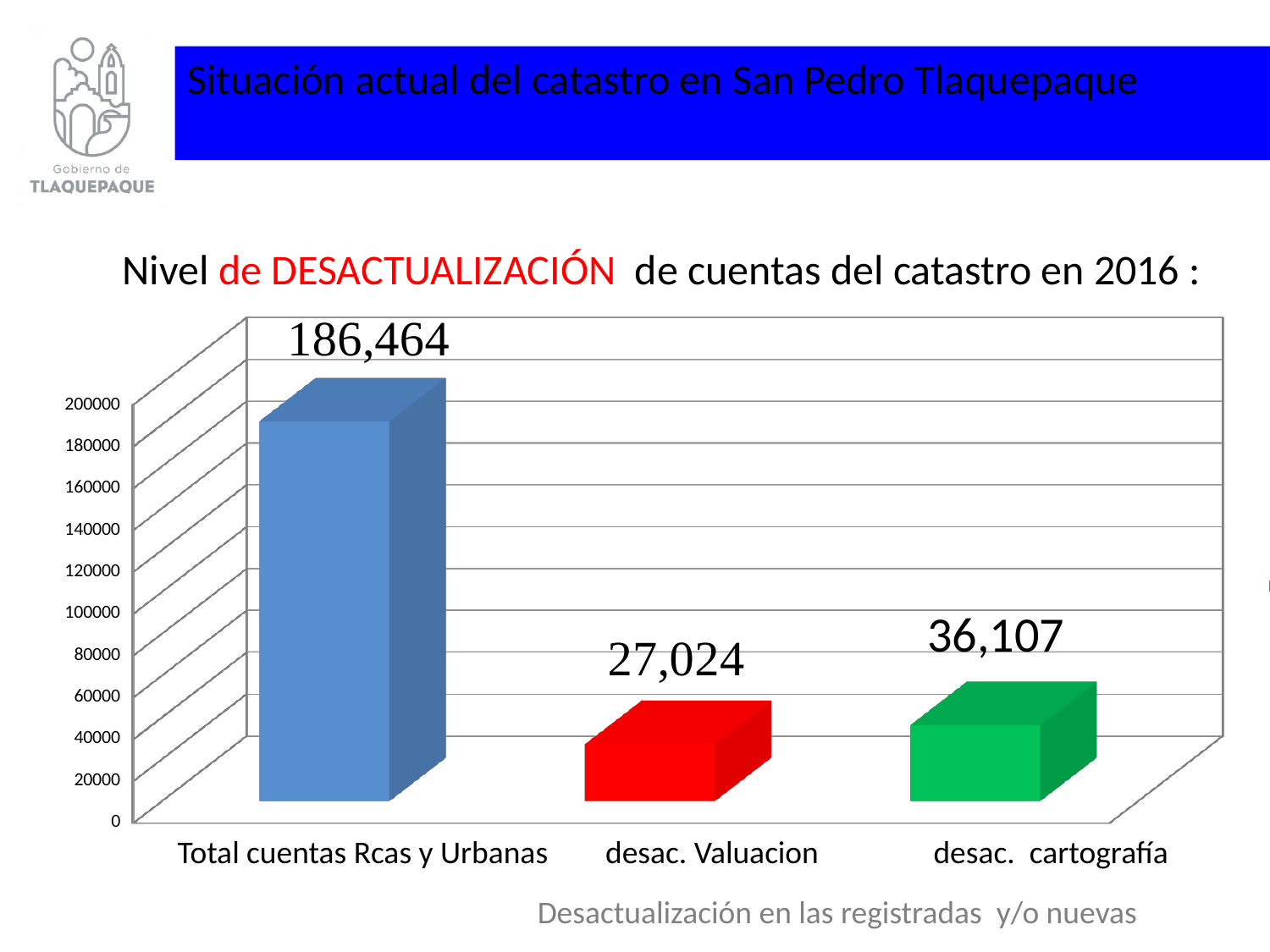
What colour is the bar for desac. Valuacion? red What is the value for Total cuentas Rcas y Urbanas? 186,464 What is the difference between the values for desac. cartografía and desac. Valuacion? 9,083 Is the value for desac. Valuacion greater or less than 40000? less What is the value for desac. cartografía? 36,107 Which category has the lowest value? desac. Valuacion What is the value for desac. Valuacion? 27,024 Which is larger, the value for desac. Valuacion or the value for desac. cartografía? desac. cartografía How many categories are shown on the x axis? 3 Which category has the highest value? Total cuentas Rcas y Urbanas What kind of chart is shown on the slide? bar chart What is the difference between the values for Total cuentas Rcas y Urbanas and desac. cartografía? 150,357